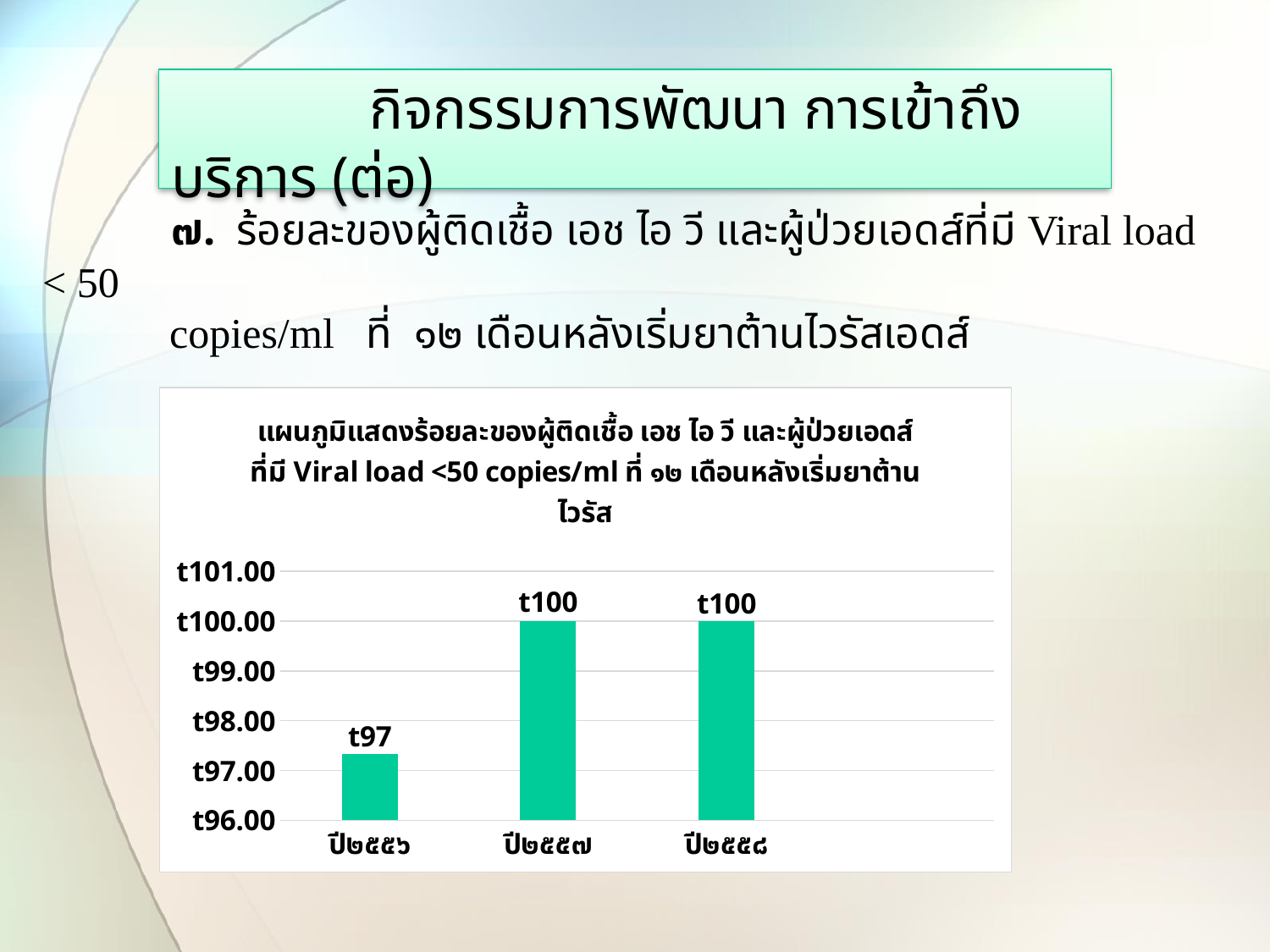
What colour are the bars in the chart? green What is the value shown for ปี๒๕๕๖? t97 Which category has the lowest value? ปี๒๕๕๖ By how much does the value for ปี๒๕๕๗ exceed the value for ปี๒๕๕๖? 3 Which is larger, the value for ปี๒๕๕๖ or the value for ปี๒๕๕๗? ปี๒๕๕๗ Is the value for ปี๒๕๕๖ greater or less than t98.00? less Does the value rise or fall from ปี๒๕๕๖ to ปี๒๕๕๗? rise Is the value for ปี๒๕๕๘ greater or less than t99.00? greater What is the value shown for ปี๒๕๕๘? t100 What is the value shown for ปี๒๕๕๗? t100 How many categories are shown on the x axis? 3 What kind of chart is shown on the slide? bar chart